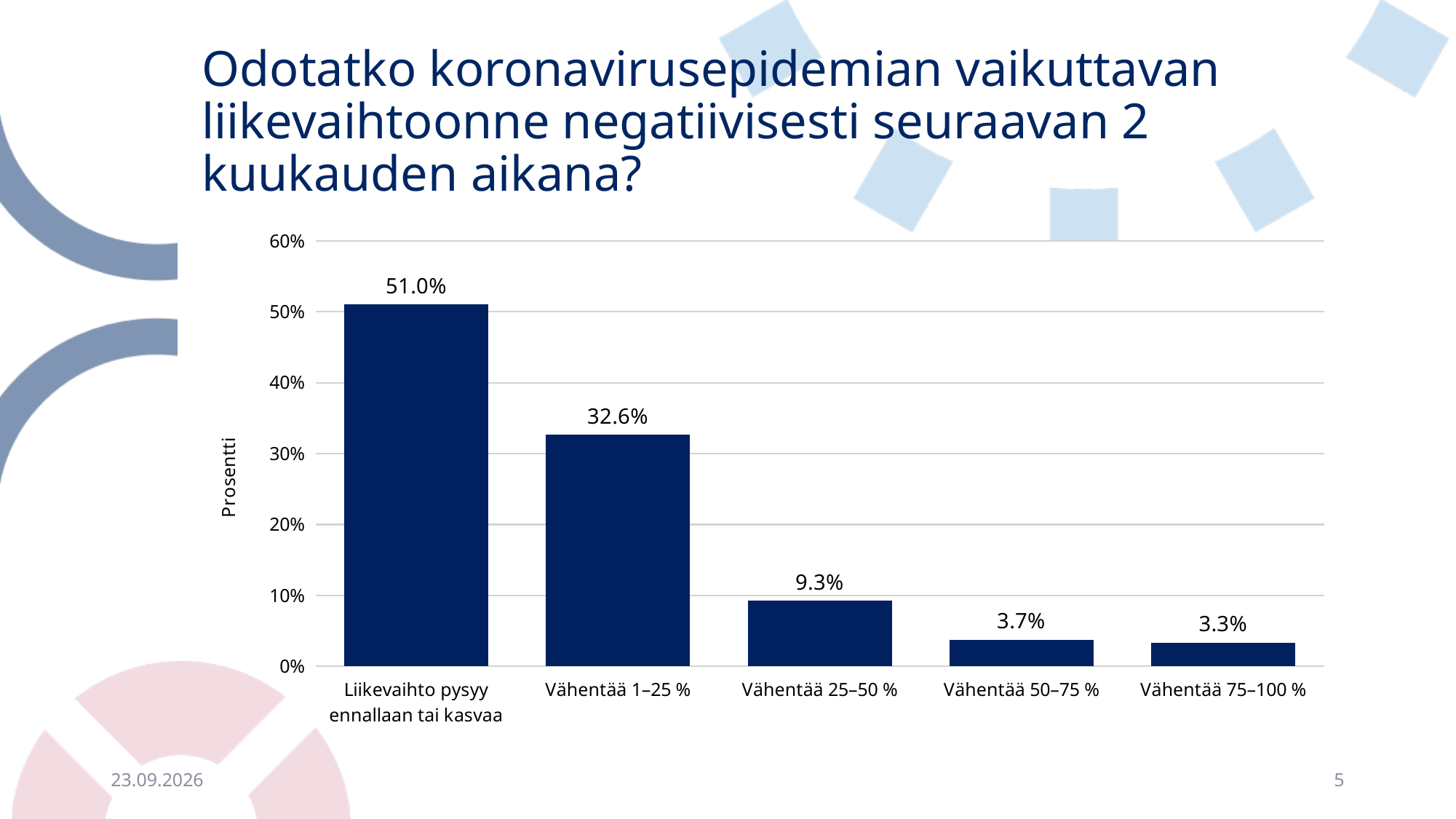
Which category has the highest value? Liikevaihto pysyy ennallaan tai kasvaa What is the difference between the values for "Liikevaihto pysyy ennallaan tai kasvaa" and "Vähentää 1–25 %"? 18.4% How many categories are shown on the x axis? 5 What is the label of the vertical axis? Prosentti What is the value for "Vähentää 25–50 %"? 9.3% What is the value for "Vähentää 75–100 %"? 3.3% What is the value for "Liikevaihto pysyy ennallaan tai kasvaa"? 51.0% Which category has the lowest value? Vähentää 75–100 % Which is larger, the value for "Vähentää 25–50 %" or "Vähentää 50–75 %"? Vähentää 25–50 % What kind of chart is shown on the slide? bar chart Is the value for "Vähentää 1–25 %" greater or less than 30%? greater What is the value for "Vähentää 1–25 %"? 32.6%